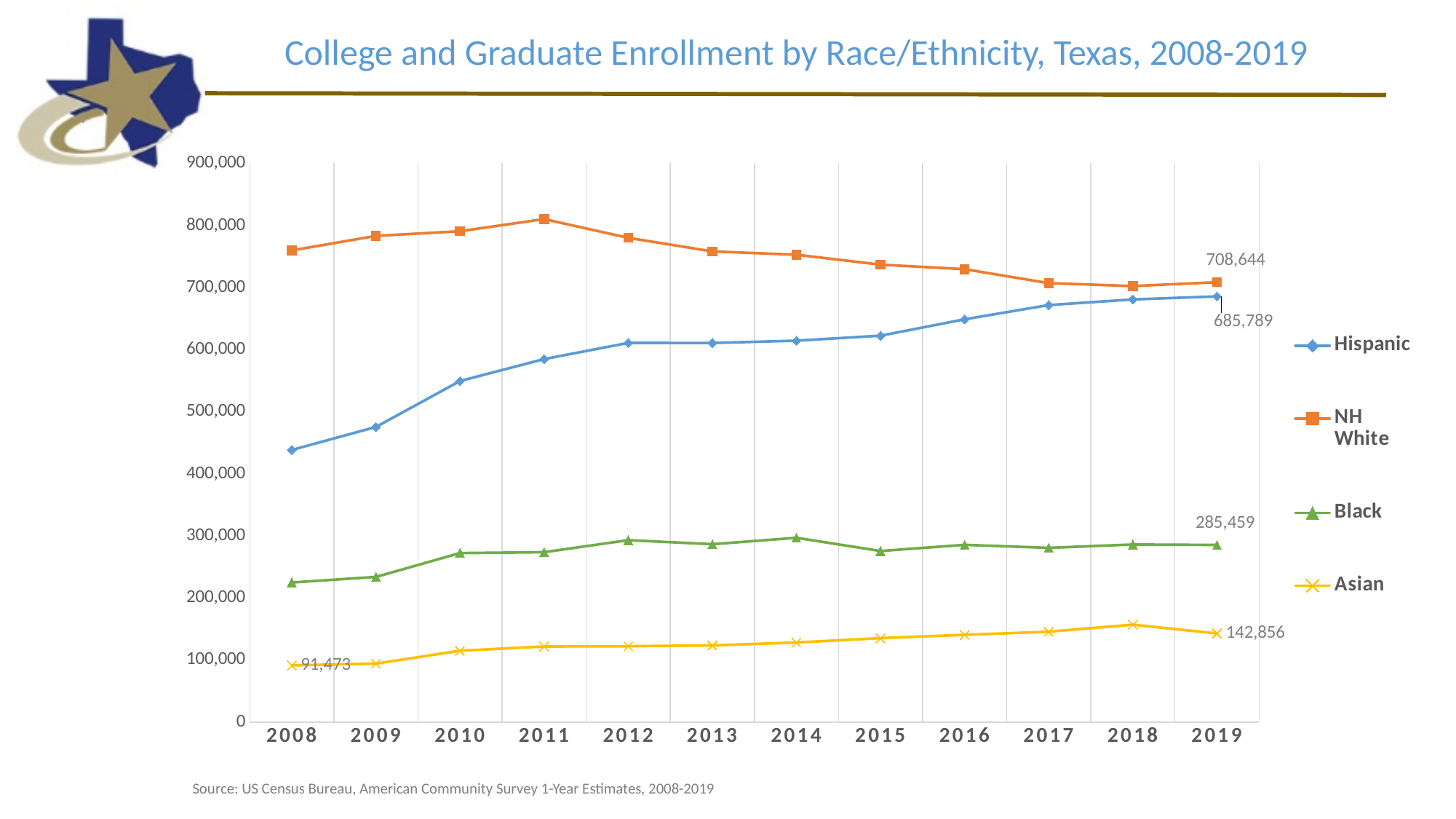
What is the difference between the NH White and Hispanic enrollment values in 2019? 22,855 How many years are shown on the x axis? 12 Which series has the lowest enrollment in 2019? Asian What type of chart is shown on the slide? line chart What is the Asian enrollment value in 2008? 91,473 How many series does the legend list? 4 By how much did Asian enrollment increase from 2008 to 2019? 51,383 What is the Black enrollment value in 2019? 285,459 Does Hispanic enrollment rise or fall from 2008 to 2019? rise Is the Hispanic enrollment value for 2008 greater or less than 500,000? less What is the Hispanic enrollment value in 2019? 685,789 What is the NH White enrollment value in 2019? 708,644